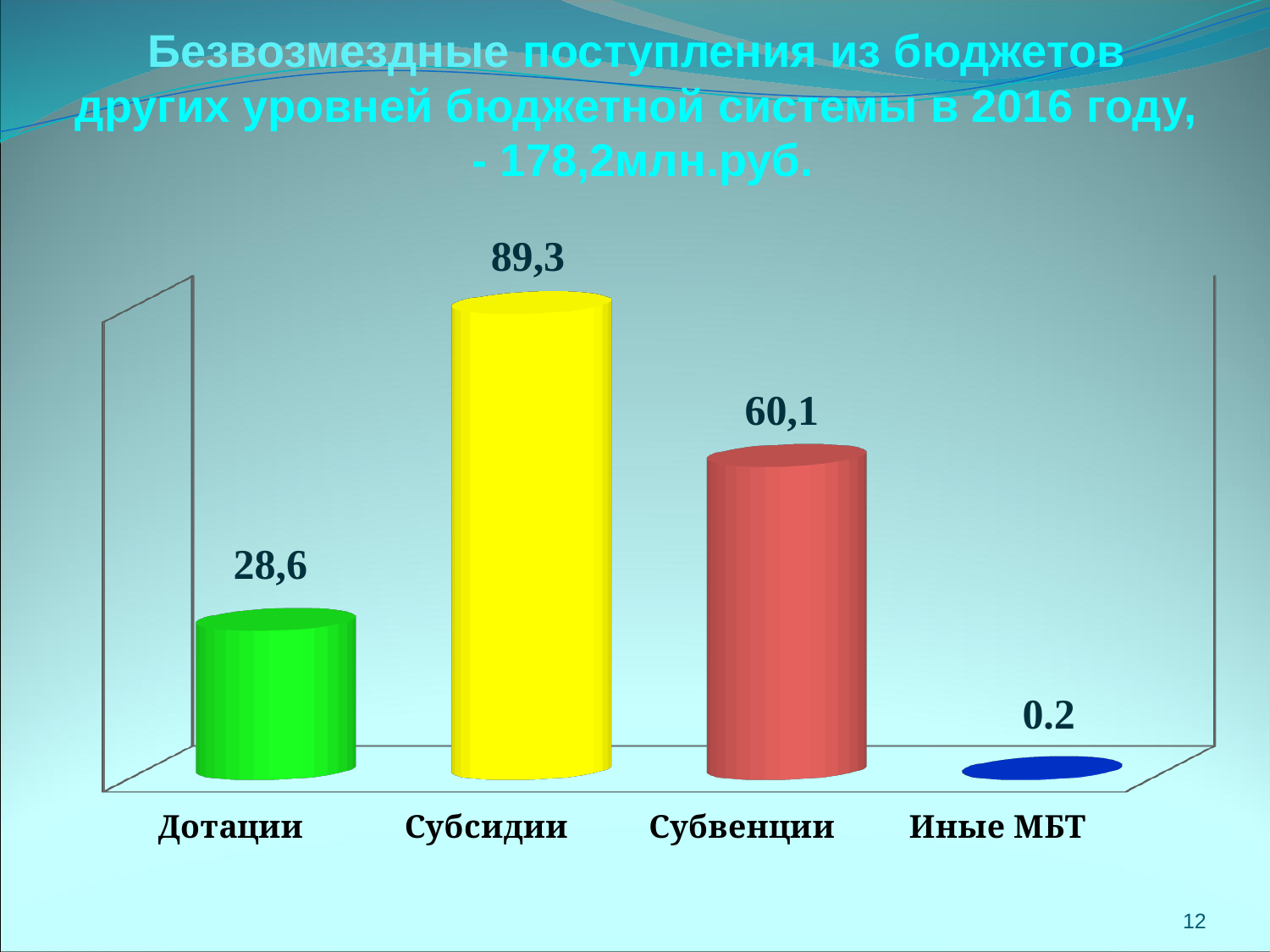
What is the value for Субвенции? 60,1 Which is larger, the value for Дотации or the value for Субвенции? Субвенции Which category has the lowest value? Иные МБТ What kind of chart is shown on the slide? Bar chart What is the value for Субсидии? 89,3 What colour is the bar for Субсидии? Yellow What is the value for Дотации? 28,6 What is the difference between the values for Субсидии and Субвенции? 29,2 Which category has the highest value? Субсидии What is the value for Иные МБТ? 0.2 What is the difference between the values for Субвенции and Дотации? 31,5 How many categories are shown in the chart? 4